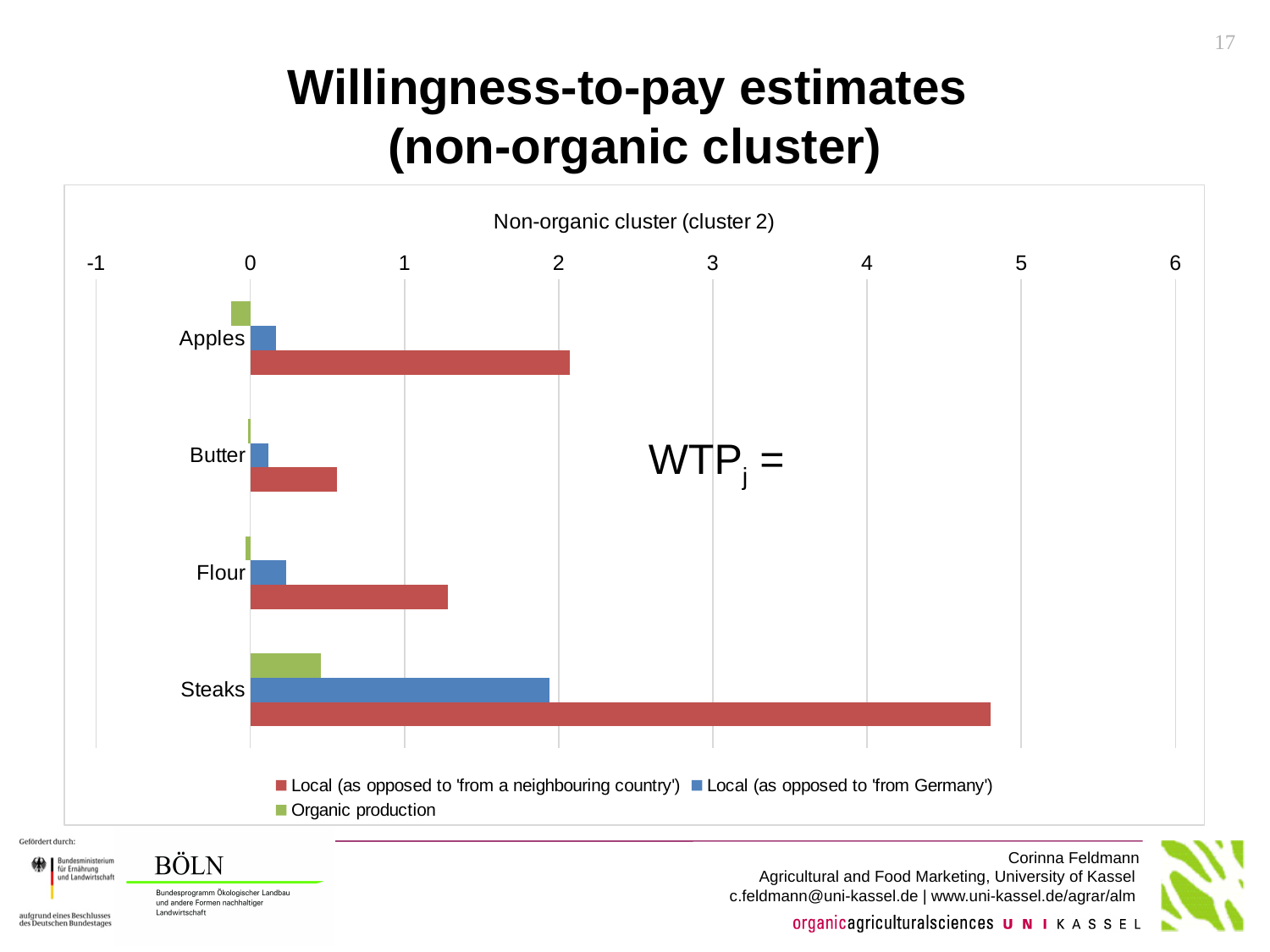
Is the value for Flour in the 'Local (as opposed to 'from a neighbouring country'')' series greater or less than 1? greater Is the value for Butter in the 'Local (as opposed to 'from a neighbouring country'')' series greater or less than 1? less What is the title shown inside the chart area? Non-organic cluster (cluster 2) Which product has the lowest value for 'Local (as opposed to 'from a neighbouring country'')'? Butter How many series does the chart's legend list? 3 Is the value for Steaks in the 'Local (as opposed to 'from Germany'')' series greater or less than 1? greater How many product categories are shown on the chart? 4 Which product has the highest value for 'Local (as opposed to 'from a neighbouring country'')'? Steaks Which product has the highest value for 'Organic production'? Steaks For the 'Local (as opposed to 'from a neighbouring country'')' series, which is larger: Apples or Flour? Apples What kind of chart is shown on the slide? Bar chart